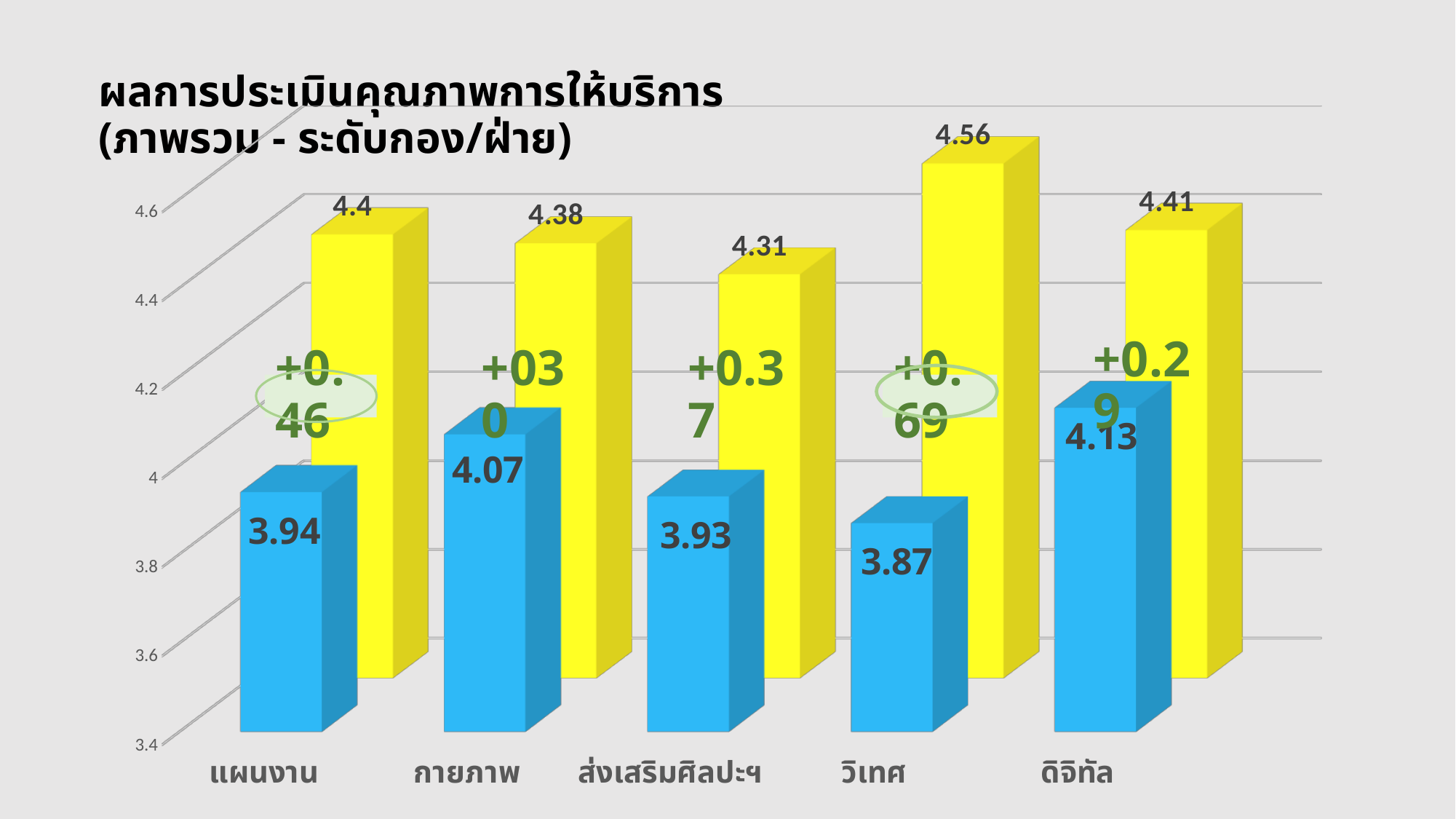
What is the value of the blue bar for แผนงาน? 3.94 Which category has the highest blue bar? ดิจิทัล What is the value of the yellow bar for กายภาพ? 4.38 What is the value of the yellow bar for วิเทศ? 4.56 How many categories are shown on the x axis? 5 What is the difference between the yellow bar and the blue bar for แผนงาน? 0.46 Which is larger: the blue bar for กายภาพ or the blue bar for ดิจิทัล? ดิจิทัล Which category has the lowest blue bar? วิเทศ Which category has the highest yellow bar? วิเทศ What is the value of the blue bar for ดิจิทัล? 4.13 Is the value of the blue bar for วิเทศ greater or less than 4? less What kind of chart is shown on the slide? bar chart